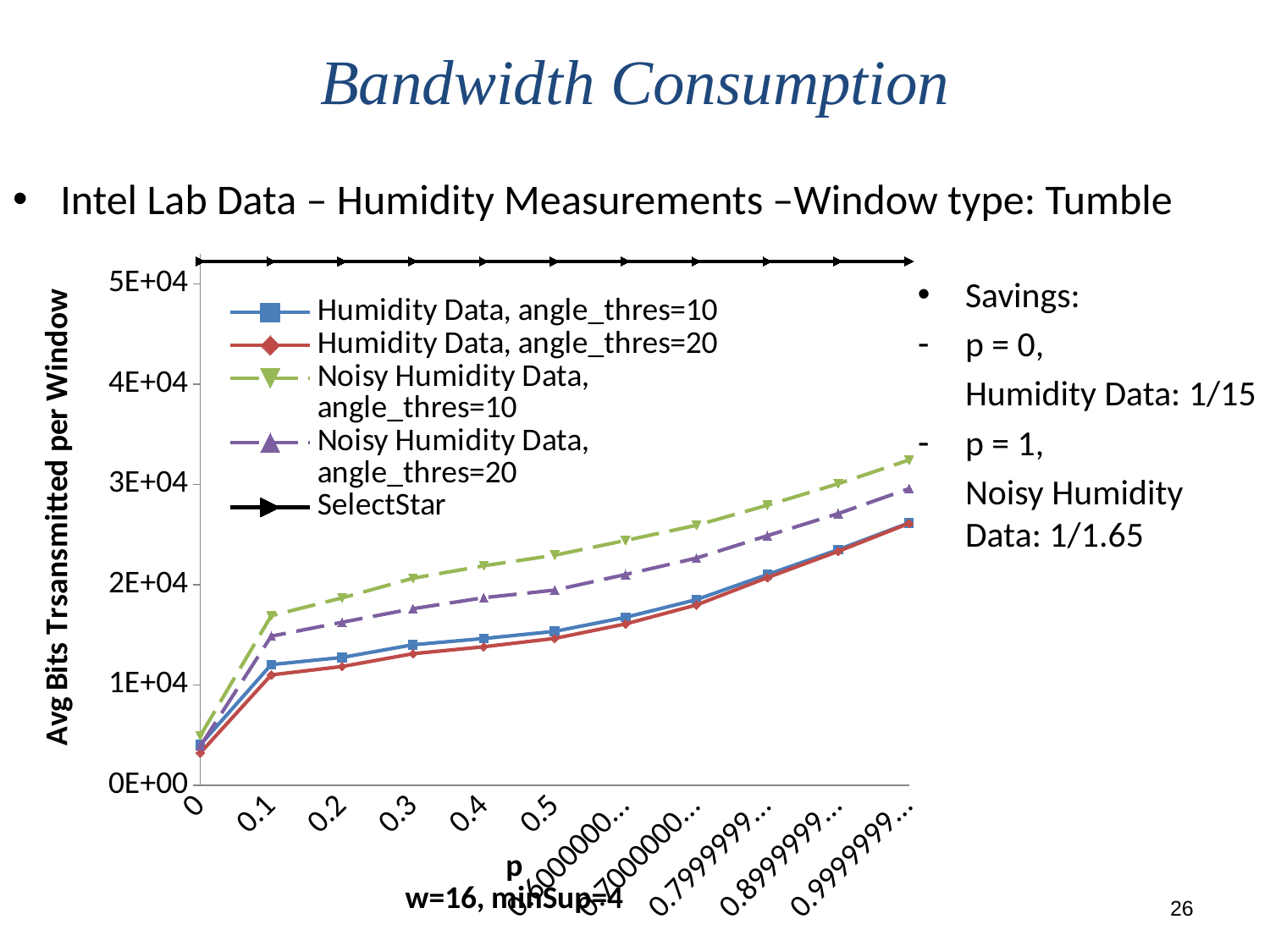
What parameter setting is printed below the x axis of the chart? w=16, minSup=4 Is the value for Noisy Humidity Data, angle_thres=10 at p = 0.1 greater or less than 1E+04? greater Which series has the lowest value at p = 0.1? Humidity Data, angle_thres=20 What is the label of the y axis? Avg Bits Trsansmitted per Window Does the Humidity Data, angle_thres=10 series rise or fall as p increases? rises How many series does the chart legend list? 5 Is the value for Humidity Data, angle_thres=10 at p = 0.5 greater or less than 2E+04? less What kind of chart is shown on the slide? line chart Is the value for SelectStar greater or less than 4E+04? greater How many p values are plotted along the x axis? 11 Which series has the highest values across the chart? SelectStar At p = 0.5, which is larger: Noisy Humidity Data, angle_thres=10 or Humidity Data, angle_thres=20? Noisy Humidity Data, angle_thres=10